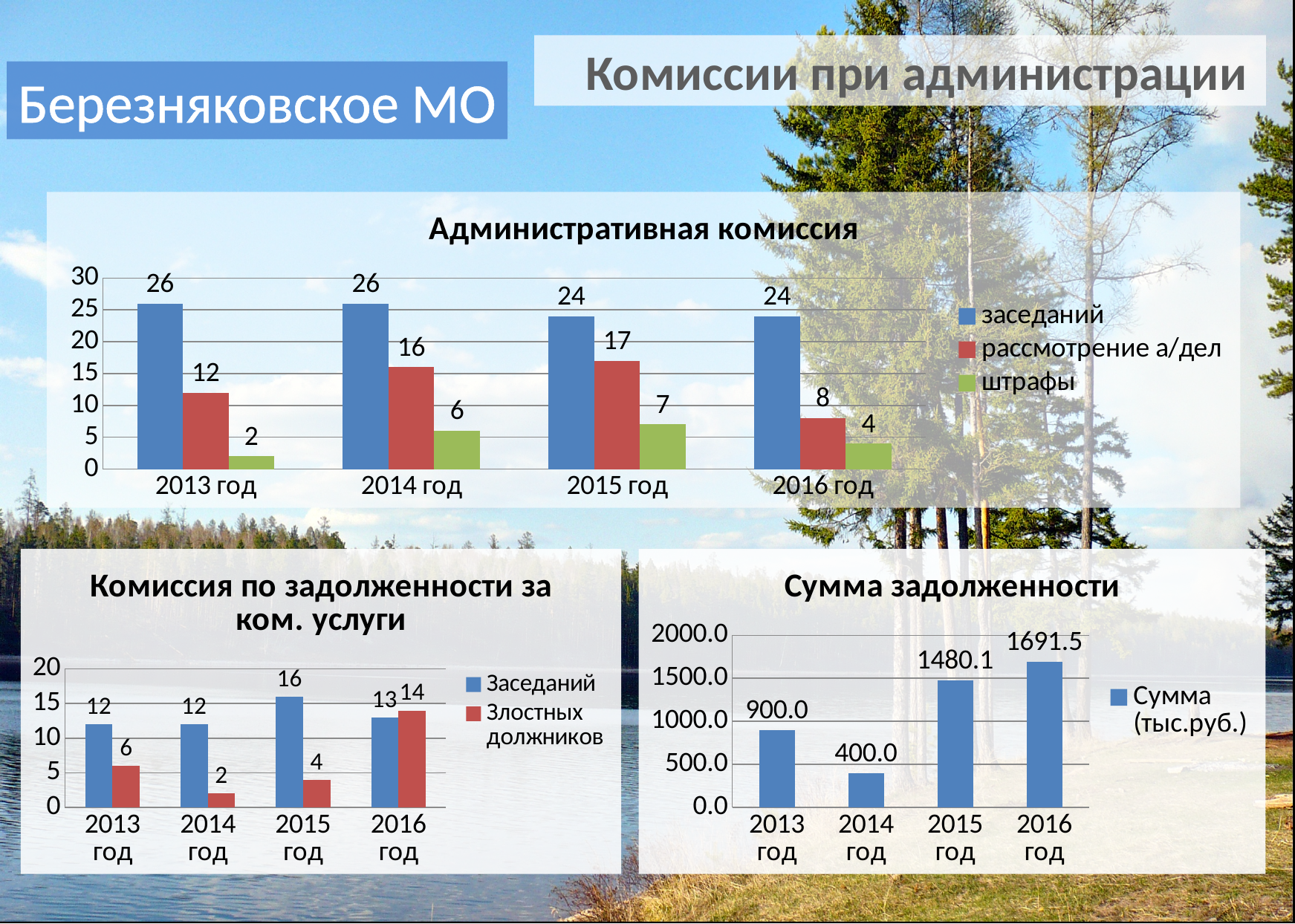
In the chart 'Комиссия по задолженности за ком. услуги', which is larger in 2015 год: 'Заседаний' or 'Злостных должников'? Заседаний In the chart 'Административная комиссия', what is the difference between 'заседаний' and 'рассмотрение а/дел' in 2016 год? 16 What kind of chart is 'Сумма задолженности'? bar chart In the chart 'Административная комиссия', which year has the highest value for 'штрафы'? 2015 год In the chart 'Сумма задолженности', which year has the highest value? 2016 год In the chart 'Комиссия по задолженности за ком. услуги', which year has the lowest value for 'Злостных должников'? 2014 год In the chart 'Сумма задолженности', what is the value for 2015 год? 1480.1 In the chart 'Административная комиссия', how many series does the legend list? 3 In the chart 'Административная комиссия', what is the value for 'рассмотрение а/дел' in 2015 год? 17 In the chart 'Административная комиссия', do the values for 'заседаний' rise or fall from 2013 год to 2016 год? fall In the chart 'Комиссия по задолженности за ком. услуги', what is the value for 'Злостных должников' in 2016 год? 14 In the chart 'Сумма задолженности', what is the difference between the values for 2016 год and 2014 год? 1291.5